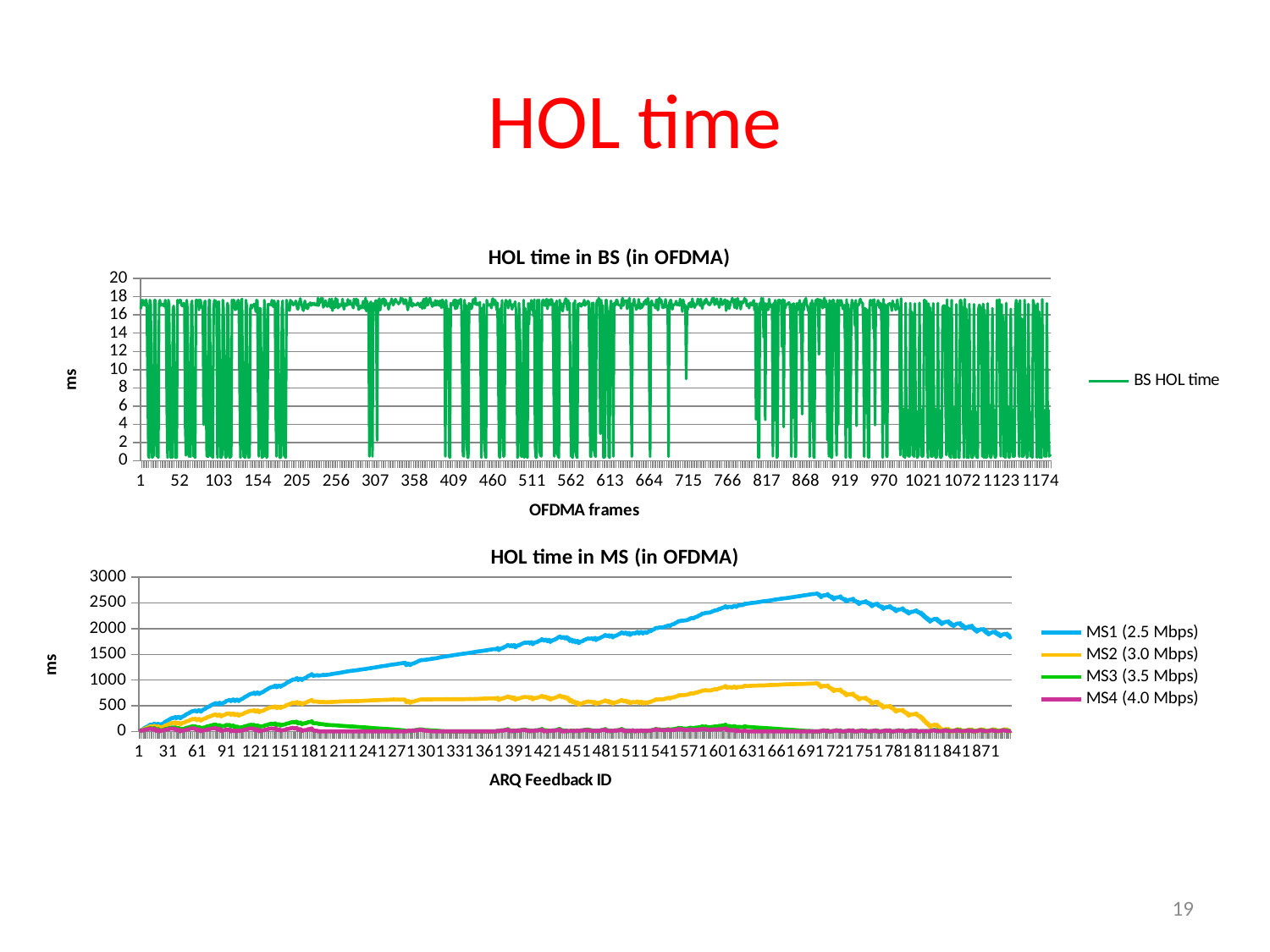
How many series does the legend of the top chart "HOL time in BS (in OFDMA)" list? 1 In the bottom chart "HOL time in MS (in OFDMA)", which series stays lowest across the x axis? MS4 (4.0 Mbps) In the bottom chart "HOL time in MS (in OFDMA)", which series reaches the highest value? MS1 (2.5 Mbps) In the top chart "HOL time in BS (in OFDMA)", is the highest value of BS HOL time greater or less than 16? greater In the bottom chart "HOL time in MS (in OFDMA)", is the peak value of MS2 (3.0 Mbps) greater or less than 500? greater In the bottom chart "HOL time in MS (in OFDMA)", at ARQ Feedback ID 691, which is larger: MS1 (2.5 Mbps) or MS2 (3.0 Mbps)? MS1 (2.5 Mbps) How many series does the legend of the bottom chart "HOL time in MS (in OFDMA)" list? 4 In the bottom chart "HOL time in MS (in OFDMA)", does MS1 (2.5 Mbps) rise or fall between ARQ Feedback ID 1 and 691? rise What is the x-axis label of the top chart "HOL time in BS (in OFDMA)"? OFDMA frames What kind of chart is the top chart titled "HOL time in BS (in OFDMA)"? line chart In the bottom chart "HOL time in MS (in OFDMA)", is the peak value of MS1 (2.5 Mbps) greater or less than 2500? greater What colour is the MS2 (3.0 Mbps) line in the bottom chart "HOL time in MS (in OFDMA)"? yellow